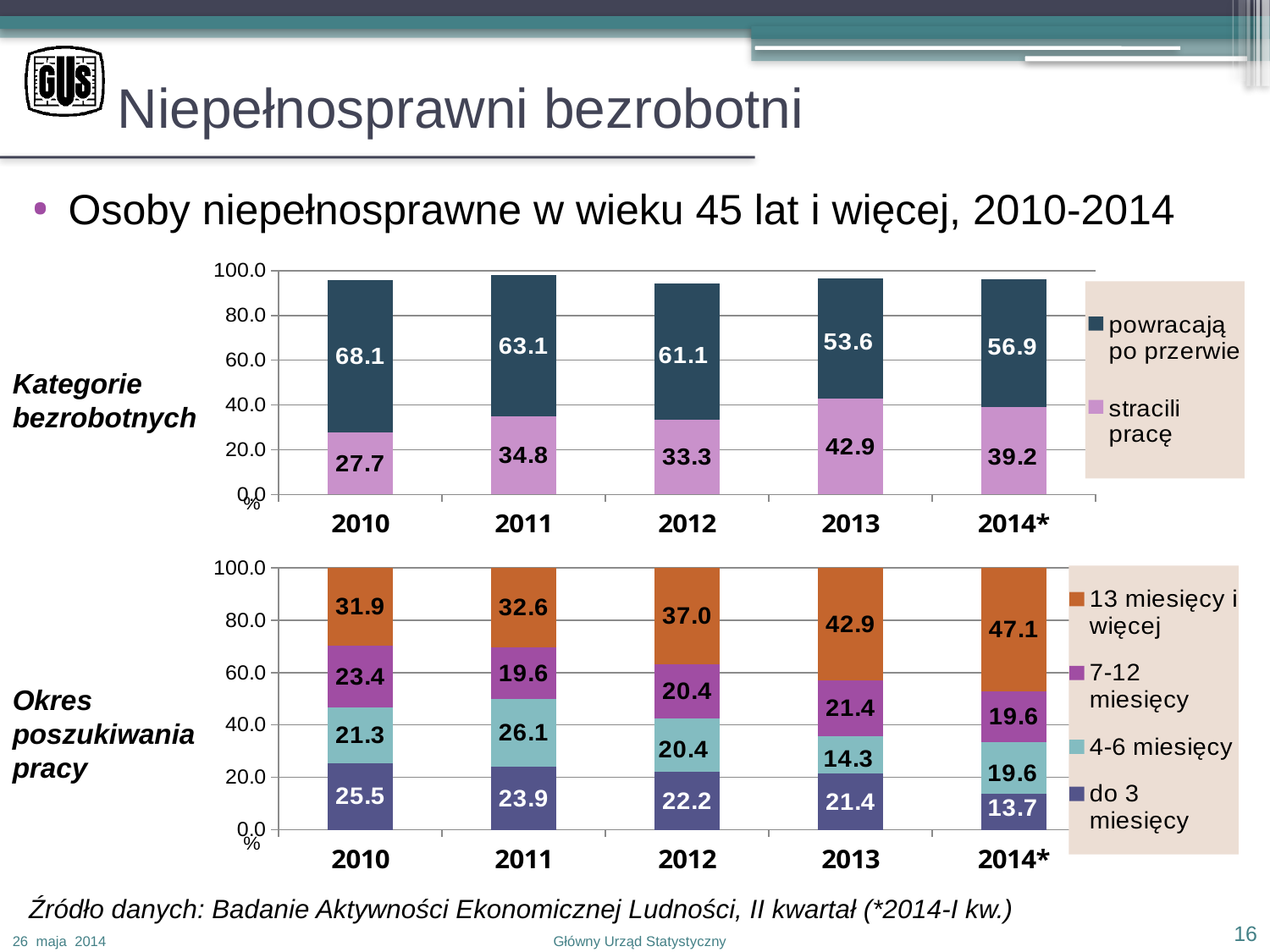
In the bottom chart (Okres poszukiwania pracy), does the value for '13 miesięcy i więcej' rise or fall from 2010 to 2014*? rise How many series does the legend of the bottom chart (Okres poszukiwania pracy) list? 4 What kind of chart is the top chart (Kategorie bezrobotnych)? stacked bar chart In the top chart (Kategorie bezrobotnych), which year has the lowest value for 'stracili pracę'? 2010 In the bottom chart (Okres poszukiwania pracy), which is larger in 2012: '7-12 miesięcy' or 'do 3 miesięcy'? do 3 miesięcy In the bottom chart (Okres poszukiwania pracy), what is the value for 'do 3 miesięcy' in 2011? 23.9 In the top chart (Kategorie bezrobotnych), which year has the highest value for 'powracają po przerwie'? 2010 In the top chart (Kategorie bezrobotnych), what is the difference between 'powracają po przerwie' and 'stracili pracę' in 2014*? 17.7 In the bottom chart (Okres poszukiwania pracy), which year has the lowest value for '4-6 miesięcy'? 2013 In the top chart (Kategorie bezrobotnych), what is the value for 'stracili pracę' in 2013? 42.9 In the bottom chart (Okres poszukiwania pracy), what is the value for '13 miesięcy i więcej' in 2014*? 47.1 In the top chart (Kategorie bezrobotnych), what is the value for 'powracają po przerwie' in 2010? 68.1